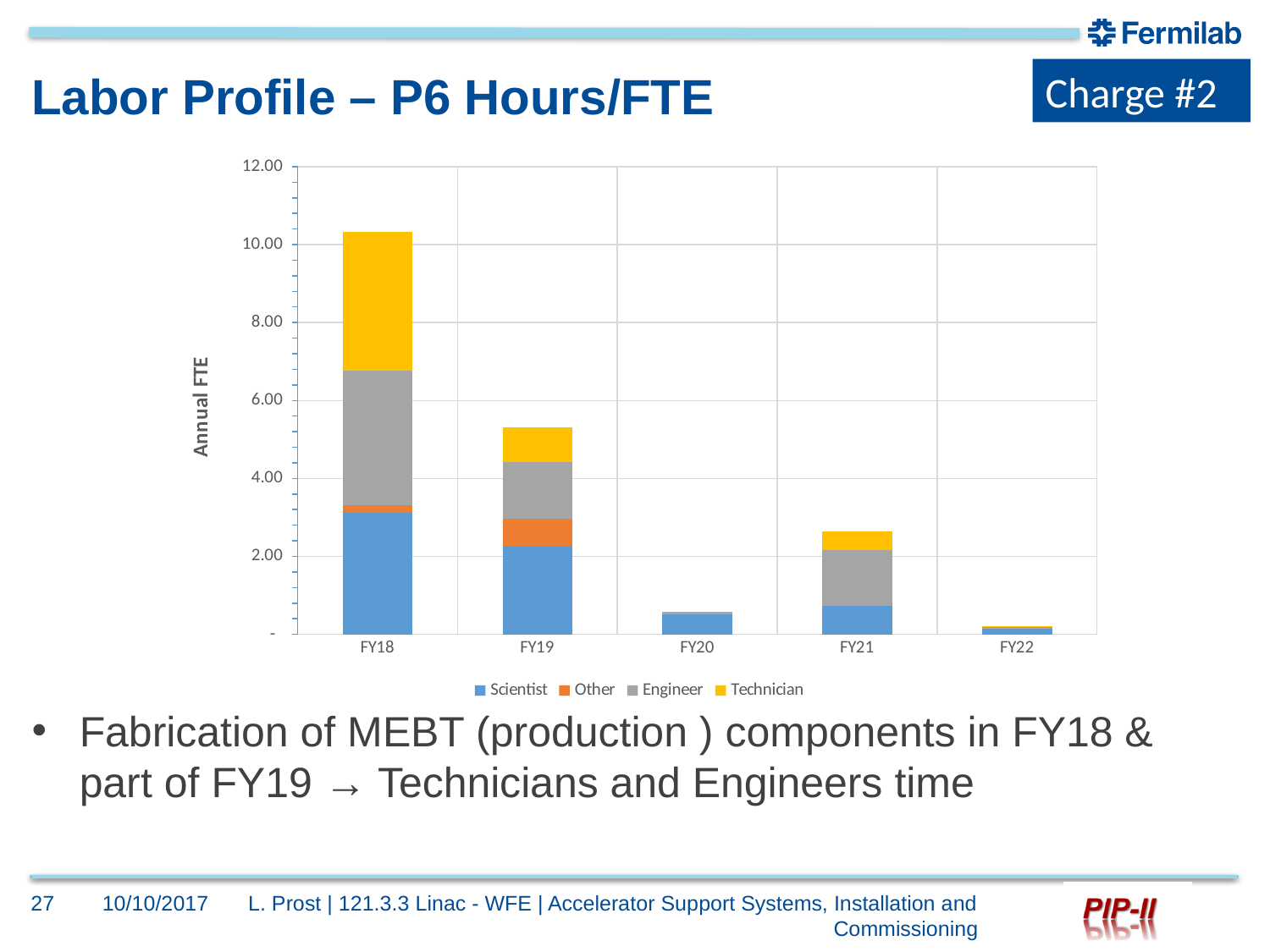
Which series is shown in yellow in the chart legend? Technician Is the total Annual FTE for FY18 greater or less than 8.00? greater Which has a larger total Annual FTE, FY19 or FY21? FY19 What is the label on the y axis of the chart? Annual FTE Which fiscal year has the lowest total Annual FTE? FY22 What kind of chart is shown on the slide? Stacked bar chart Which fiscal year has the highest total Annual FTE? FY18 How many series does the chart legend list? 4 How many fiscal years are shown on the x axis of the chart? 5 Is the total Annual FTE for FY20 greater or less than 2.00? less Is the total Annual FTE for FY19 greater or less than 4.00? greater Does the total Annual FTE rise or fall from FY18 to FY20? Fall